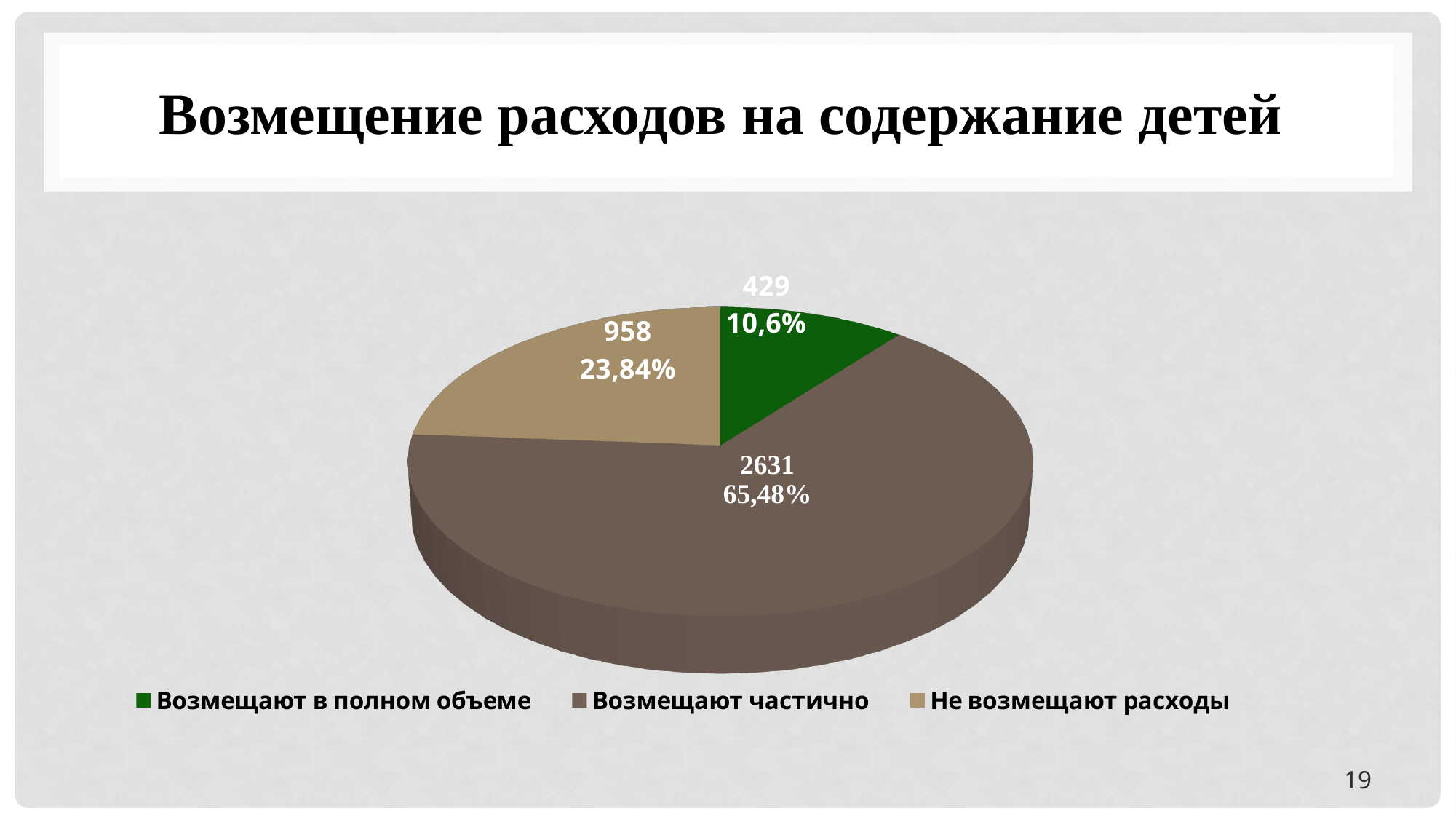
What share of the pie does "Возмещают частично" take? 65,48% What kind of chart is shown on the slide? pie chart What is the difference between the values for "Не возмещают расходы" and "Возмещают в полном объеме"? 529 What is the value for "Возмещают в полном объеме"? 429 Which category has the largest slice? Возмещают частично What share of the pie does "Не возмещают расходы" take? 23,84% Which category has the smallest slice? Возмещают в полном объеме What share of the pie does "Возмещают в полном объеме" take? 10,6% What is the value for "Возмещают частично"? 2631 What is the value for "Не возмещают расходы"? 958 How many categories does the pie chart have? 3 What is the title of the slide? Возмещение расходов на содержание детей